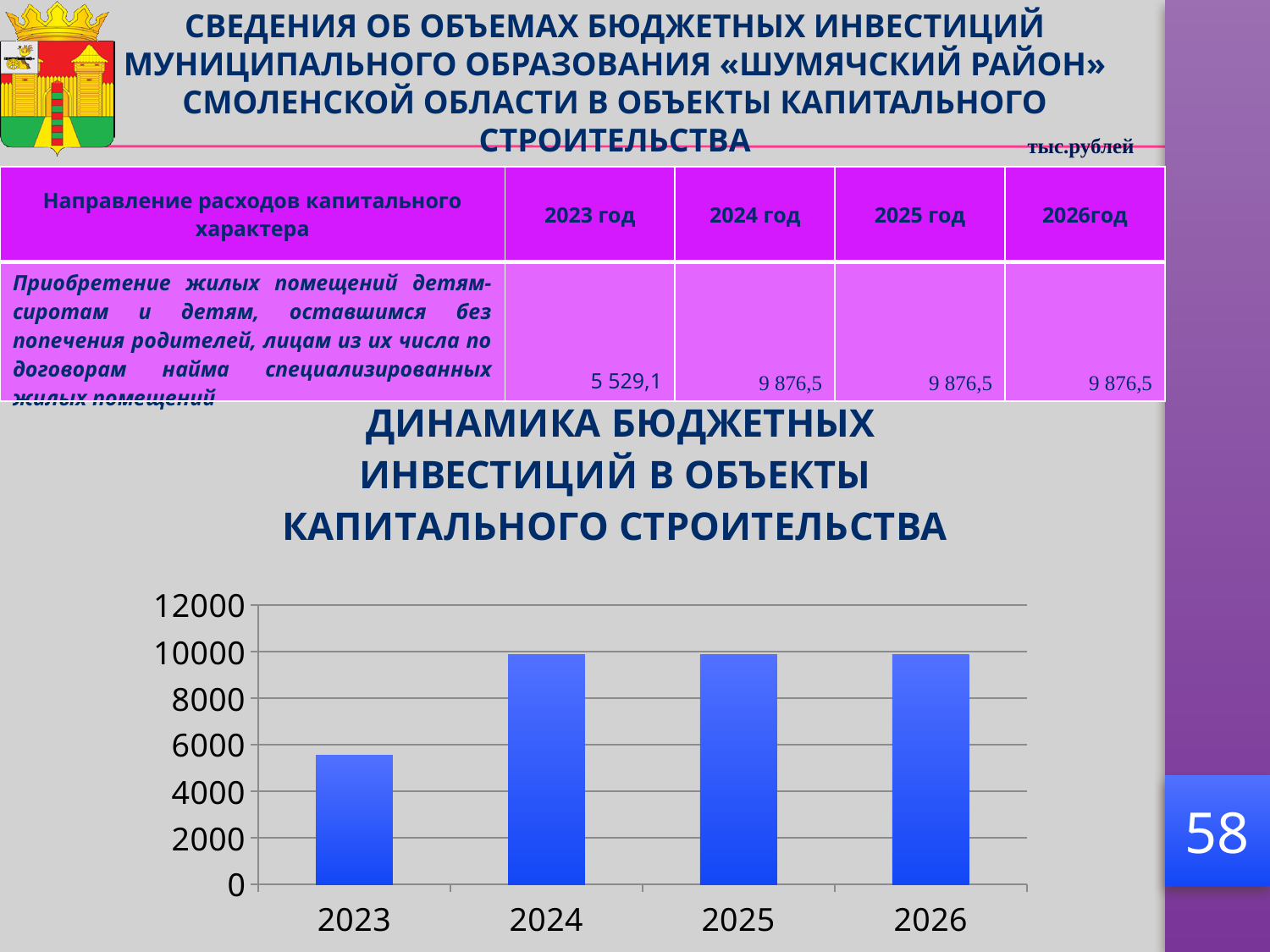
What kind of chart is shown on the slide? bar chart Is the value for 2023 greater or less than 6000? less How many years are shown on the x axis of the chart? 4 What is the highest value shown on the y axis of the chart? 12000 Which year has the lowest bar in the chart? 2023 Which is larger, the value for 2023 or the value for 2025? 2025 Do the values rise or fall from 2023 to 2024? rise Is the value for 2024 greater or less than 8000? greater Is the value for 2023 greater or less than 4000? greater What is the title of the chart? ДИНАМИКА БЮДЖЕТНЫХ ИНВЕСТИЦИЙ В ОБЪЕКТЫ КАПИТАЛЬНОГО СТРОИТЕЛЬСТВА